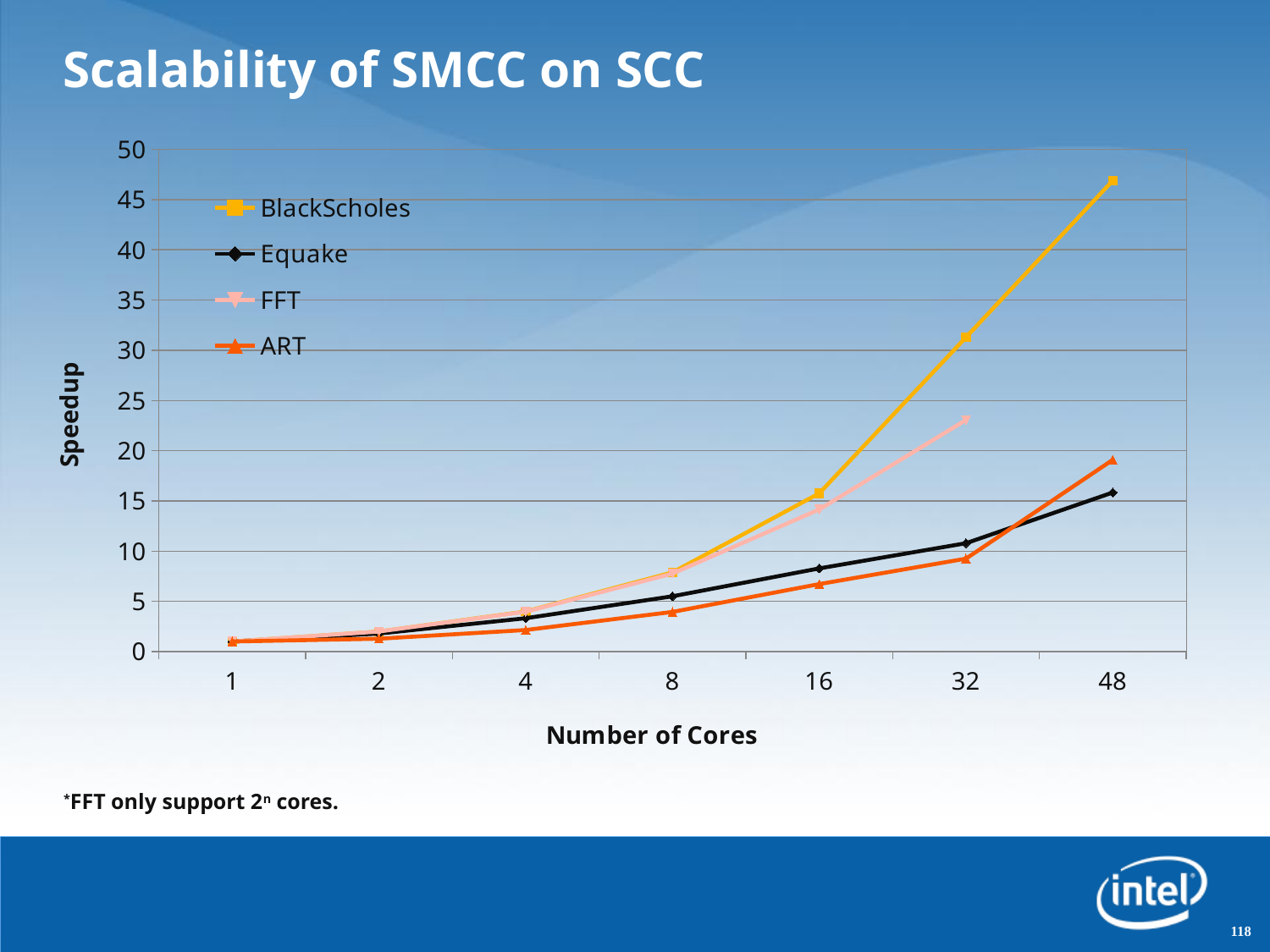
What is the label of the y axis? Speedup How many core counts are shown along the x axis? 7 Does the speedup for BlackScholes rise or fall as the number of cores increases? rise What kind of chart is shown on the slide? line chart At 48 cores, which has the larger speedup, ART or Equake? ART Is the speedup for BlackScholes at 48 cores greater or less than 45? greater At 32 cores, which has the larger speedup, Equake or ART? Equake Is the speedup for FFT at 32 cores greater or less than 25? less How many series does the legend list? 4 Which series has the highest speedup at 48 cores? BlackScholes Which series has the lowest speedup at 48 cores? Equake Is the speedup for Equake at 48 cores greater or less than 20? less